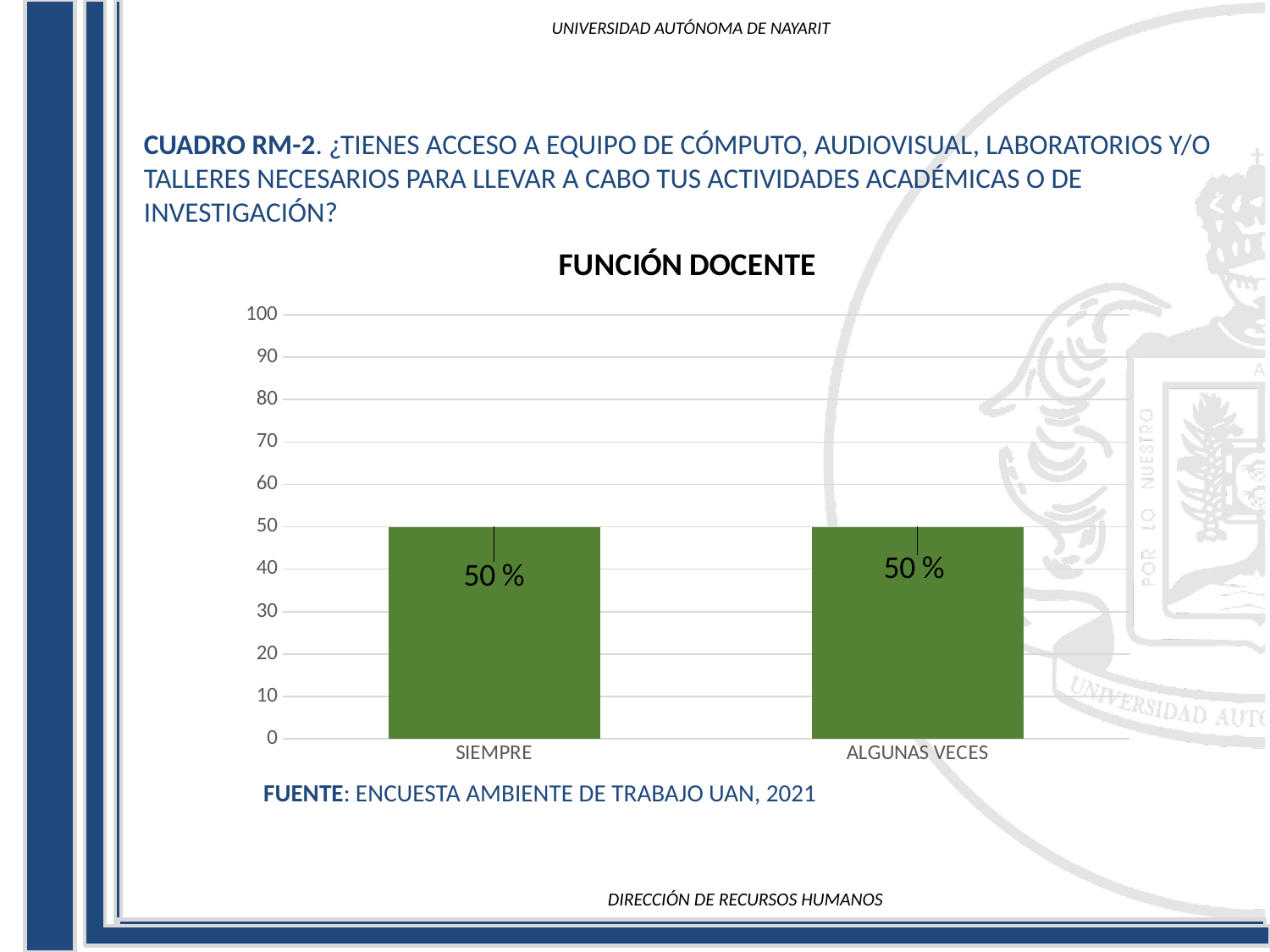
What is the title of the chart? FUNCIÓN DOCENTE What is the value for SIEMPRE? 50 % Is the value for ALGUNAS VECES greater or less than 40? greater What kind of chart is shown on the slide? bar chart Is the value for SIEMPRE greater or less than 60? less What is the difference between the values for SIEMPRE and ALGUNAS VECES? 0 % How many categories are shown on the x axis? 2 What is the highest value shown on the y axis? 100 What is the value for ALGUNAS VECES? 50 % What colour are the bars in the chart? green